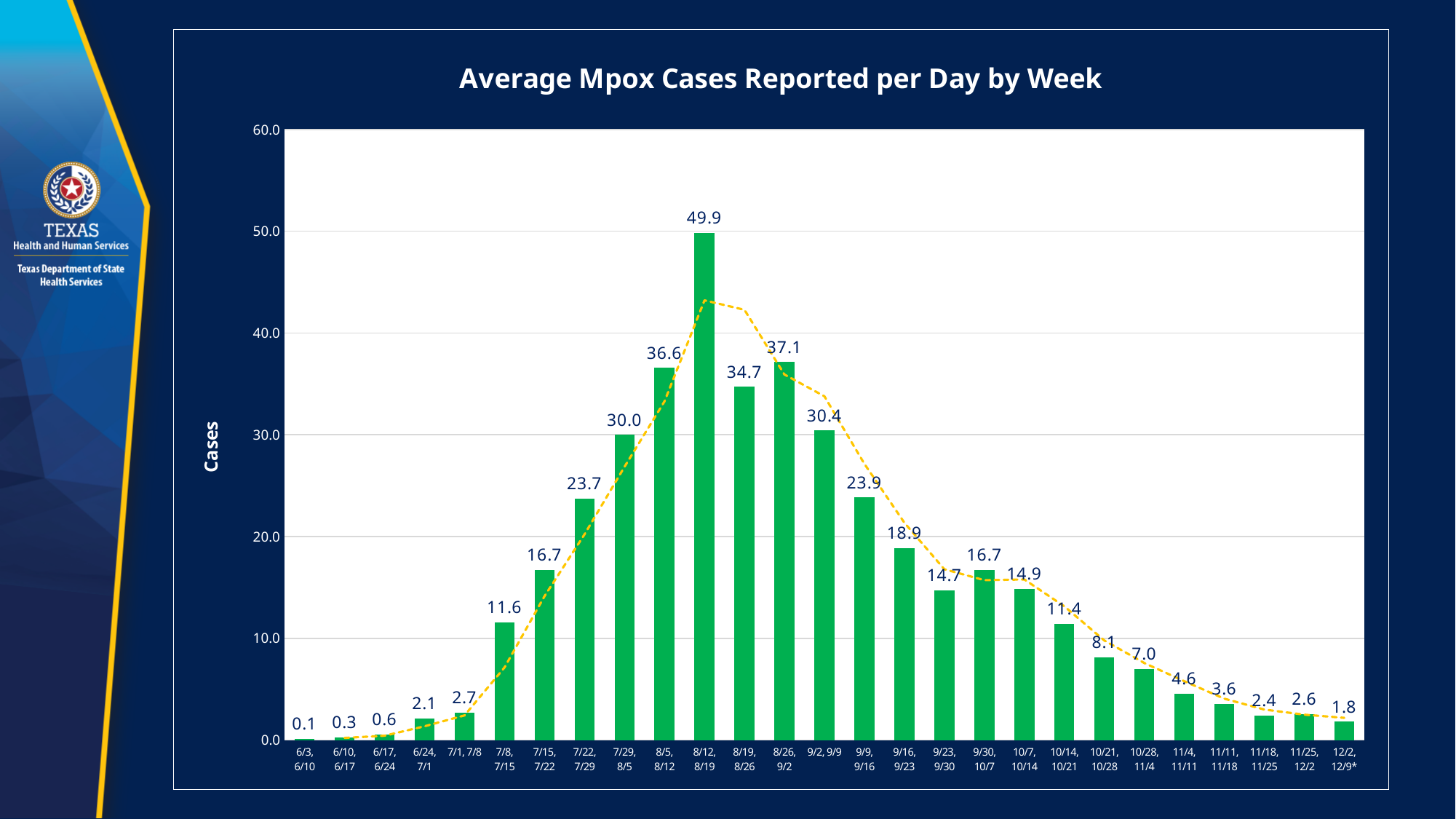
Which week has a larger value: 8/19, 8/26 or 8/26, 9/2? 8/26, 9/2 What is the value shown for the week 10/21, 10/28? 8.1 Which week has the lowest average number of cases per day? 6/3, 6/10 Is the value for the week 9/9, 9/16 greater or less than 30.0? less What is the value shown for the week 7/15, 7/22? 16.7 What is the difference between the values for the weeks 8/12, 8/19 and 8/5, 8/12? 13.3 What is the difference between the values for the weeks 8/26, 9/2 and 8/19, 8/26? 2.4 What is the label on the vertical axis? Cases What kind of chart is this? bar chart What is the average number of mpox cases per day for the week 8/12, 8/19? 49.9 How many weeks (bars) are shown on the chart? 27 Which week has the highest average number of cases per day? 8/12, 8/19